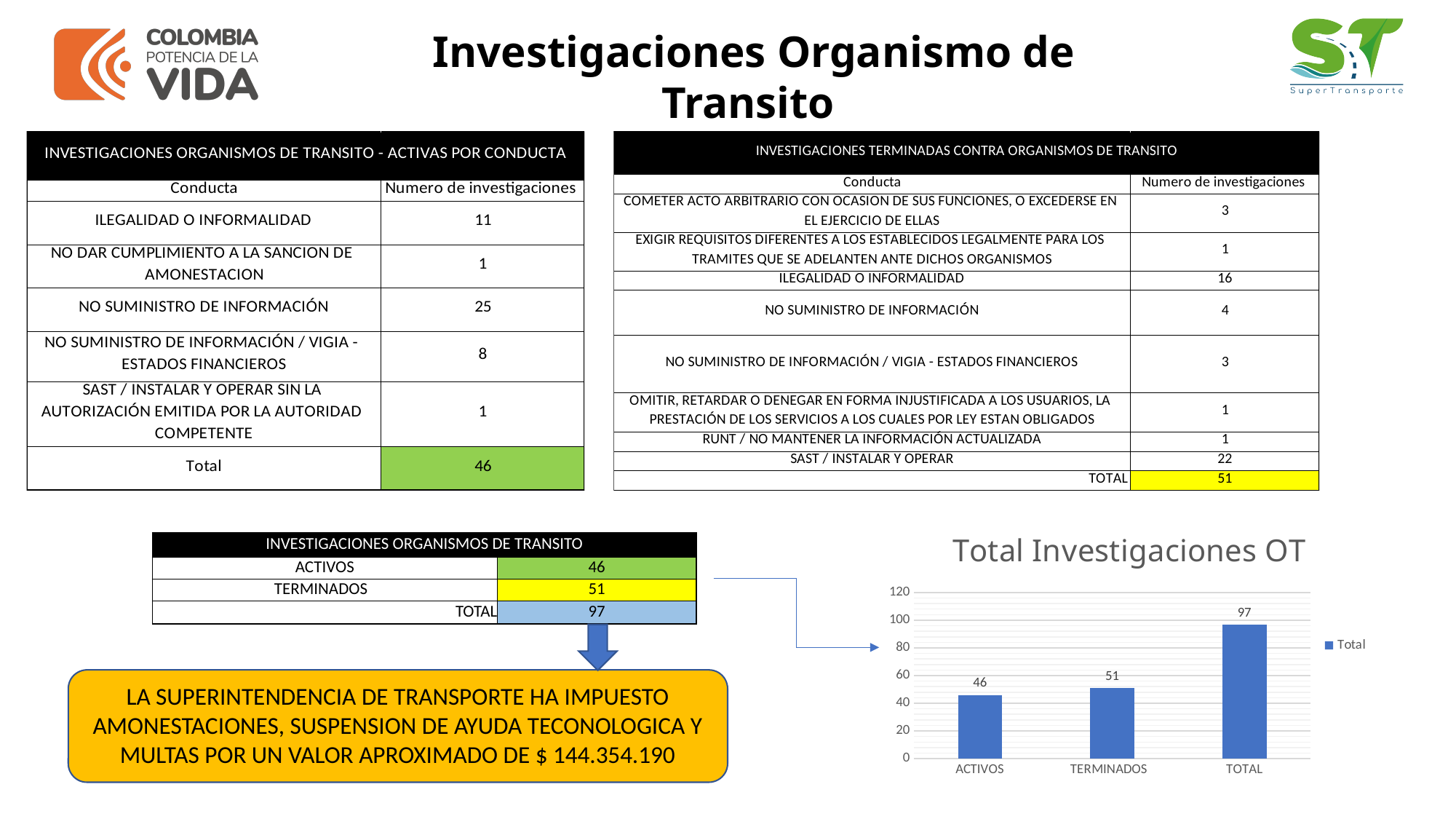
How many categories are shown on the x axis of the Total Investigaciones OT chart? 3 What is the value for TERMINADOS in the Total Investigaciones OT chart? 51 In the Total Investigaciones OT chart, which is larger, ACTIVOS or TERMINADOS? TERMINADOS Is the value for TOTAL in the Total Investigaciones OT chart greater or less than 80? greater What is the value for ACTIVOS in the Total Investigaciones OT chart? 46 What is the value for TOTAL in the Total Investigaciones OT chart? 97 How many series does the legend of the Total Investigaciones OT chart list? 1 Which category has the highest value in the Total Investigaciones OT chart? TOTAL Which category has the lowest value in the Total Investigaciones OT chart? ACTIVOS What is the difference between the TERMINADOS and ACTIVOS values in the Total Investigaciones OT chart? 5 What is the title of the chart on the slide? Total Investigaciones OT What kind of chart is the Total Investigaciones OT chart? bar chart